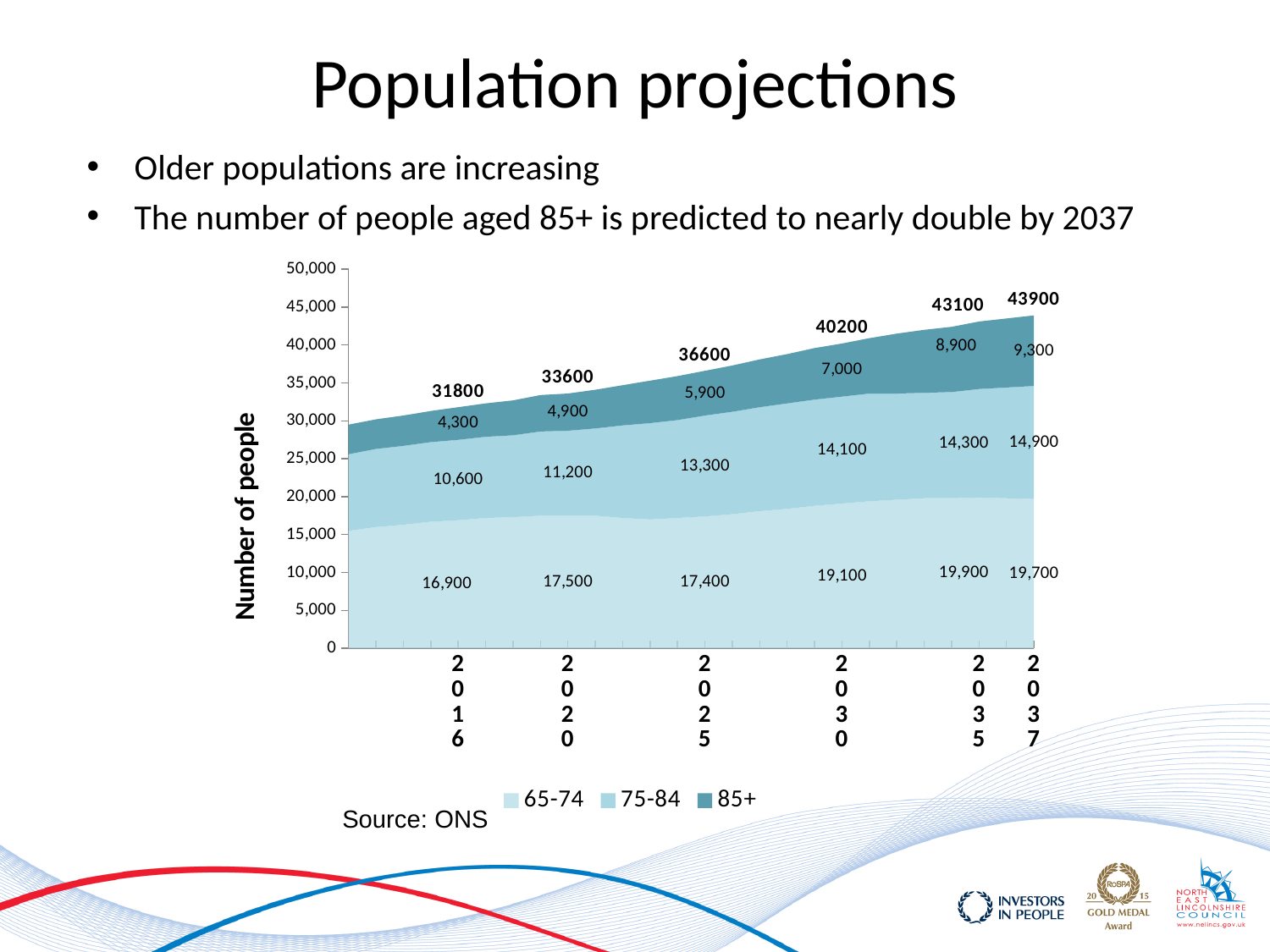
What is the total number of people shown for 2037? 43900 In which year is the 65-74 value lowest? 2016 What is the value for the 85+ series in 2016? 4,300 What is the value for the 65-74 series in 2035? 19,900 How many years are shown on the x axis? 6 What is the value for the 75-84 series in 2030? 14,100 In which year is the 85+ value highest? 2037 What kind of chart is shown? Stacked area chart What is the difference between the 85+ value in 2037 and in 2016? 5,000 Does the total number of people rise or fall from 2016 to 2037? Rise Which is larger, the 75-84 value in 2025 or the 75-84 value in 2020? 2025 How many series does the legend list? 3